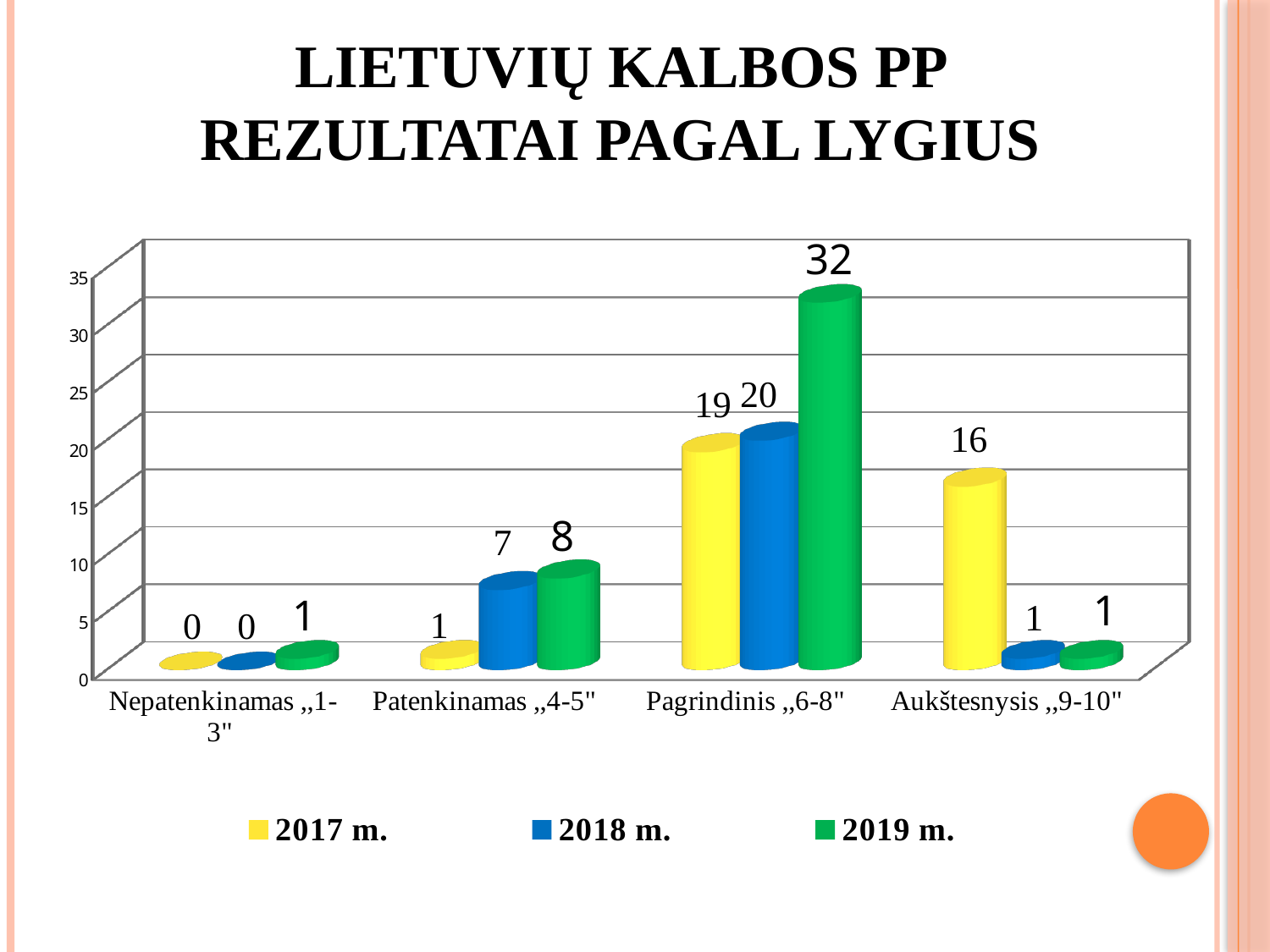
How many categories are shown on the x axis? 4 What is the value for 2017 m. in the Aukštesnysis „9-10" category? 16 Which category has the lowest value for 2017 m.? Nepatenkinamas „1-3" Which category has the highest value for 2019 m.? Pagrindinis „6-8" What is the value for 2019 m. in the Pagrindinis „6-8" category? 32 In the Aukštesnysis „9-10" category, which is larger: the 2017 m. value or the 2019 m. value? 2017 m. What kind of chart is shown on the slide? Bar chart What is the difference between the 2019 m. and 2018 m. values in the Pagrindinis „6-8" category? 12 Which colour represents 2018 m. in the chart? Blue How many series does the legend list? 3 What is the value for 2018 m. in the Patenkinamas „4-5" category? 7 What is the value for 2017 m. in the Nepatenkinamas „1-3" category? 0